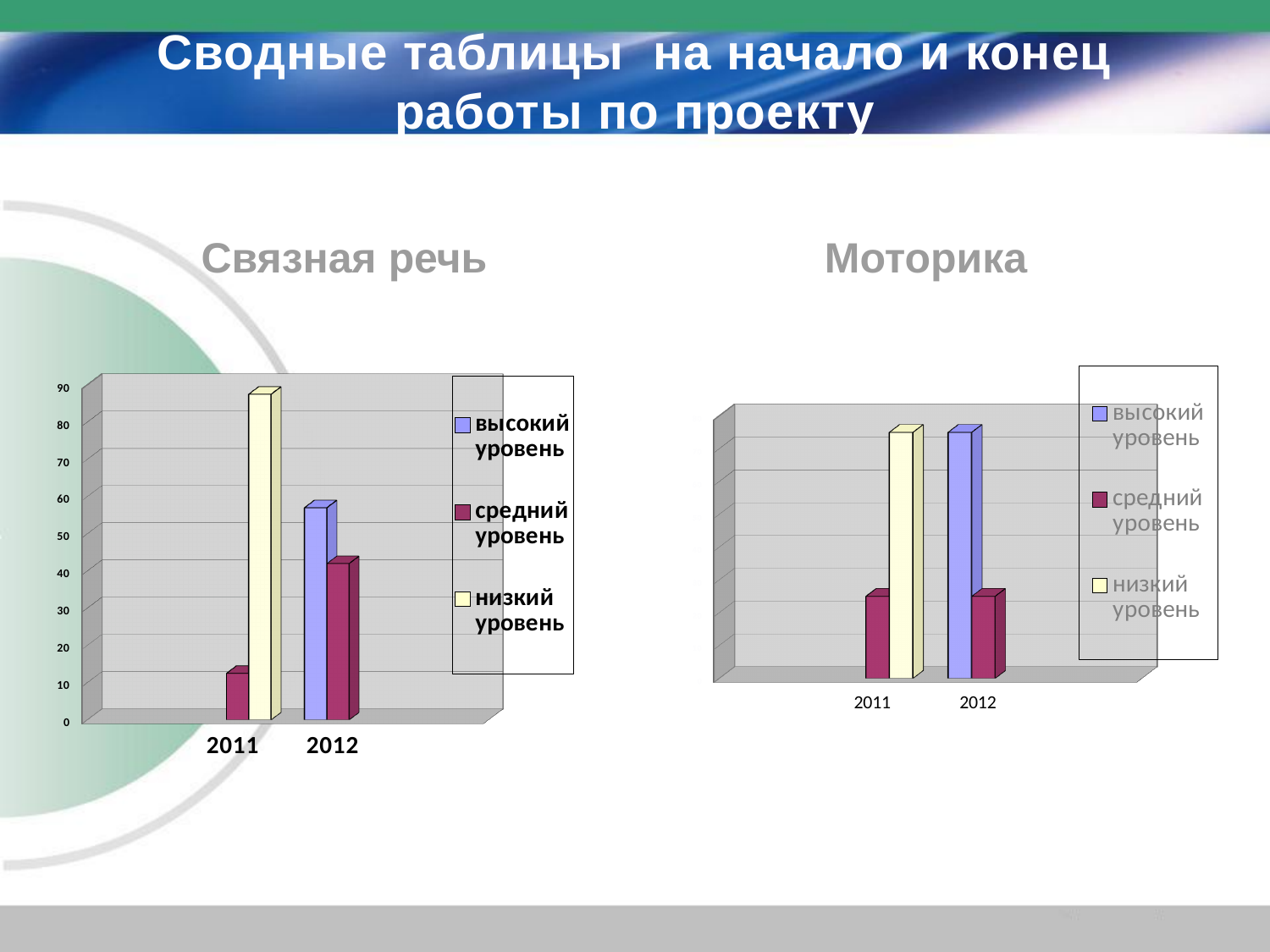
What kind of chart is the "Связная речь" chart on the left? bar chart In the "Связная речь" chart, is the value for высокий уровень in 2012 greater or less than 50? greater How many year categories are shown on the x axis of the "Моторика" chart? 2 In the "Связная речь" chart, does the value for средний уровень rise or fall from 2011 to 2012? rise In the "Моторика" chart, which is larger in 2011: средний уровень or низкий уровень? низкий уровень In the "Связная речь" chart, which is larger in 2012: высокий уровень or средний уровень? высокий уровень How many series does the legend of the "Связная речь" chart list? 3 In the "Связная речь" chart, is the value for средний уровень in 2011 greater or less than 20? less In the "Связная речь" chart, which series has the tallest bar overall? низкий уровень In the "Связная речь" chart, is the value for средний уровень in 2012 greater or less than 50? less In the "Моторика" chart, which is larger in 2012: высокий уровень or средний уровень? высокий уровень